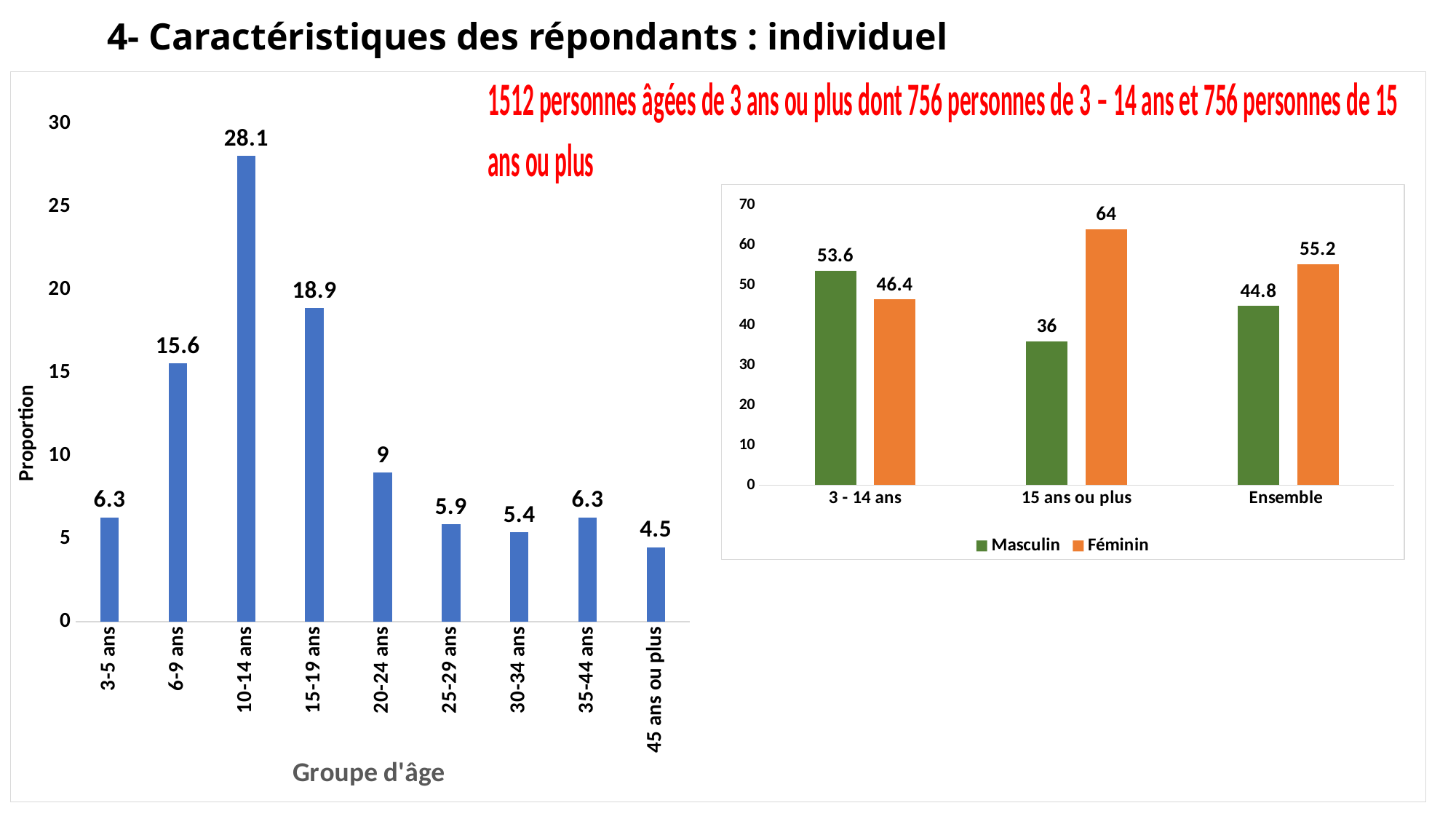
In the left chart (age group proportions), what is the value for the 20-24 ans group? 9 In the left chart (age group proportions), which age group has the lowest proportion? 45 ans ou plus In the right chart (Masculin/Féminin), what is the difference between the Féminin and Masculin values for Ensemble? 10.4 What kind of chart is the left chart (age group proportions)? Bar chart In the left chart (age group proportions), what is the difference between the 10-14 ans and 15-19 ans values? 9.2 In the left chart (age group proportions), what is the value for the 10-14 ans group? 28.1 In the right chart (Masculin/Féminin), how many series does the legend list? 2 In the right chart (Masculin/Féminin), what is the Masculin value for 3 - 14 ans? 53.6 In the left chart (age group proportions), how many age groups are shown on the x axis? 9 In the left chart (age group proportions), which age group has the highest proportion? 10-14 ans In the left chart (age group proportions), which is larger, the value for 6-9 ans or the value for 35-44 ans? 6-9 ans In the right chart (Masculin/Féminin), what is the Féminin value for 15 ans ou plus? 64